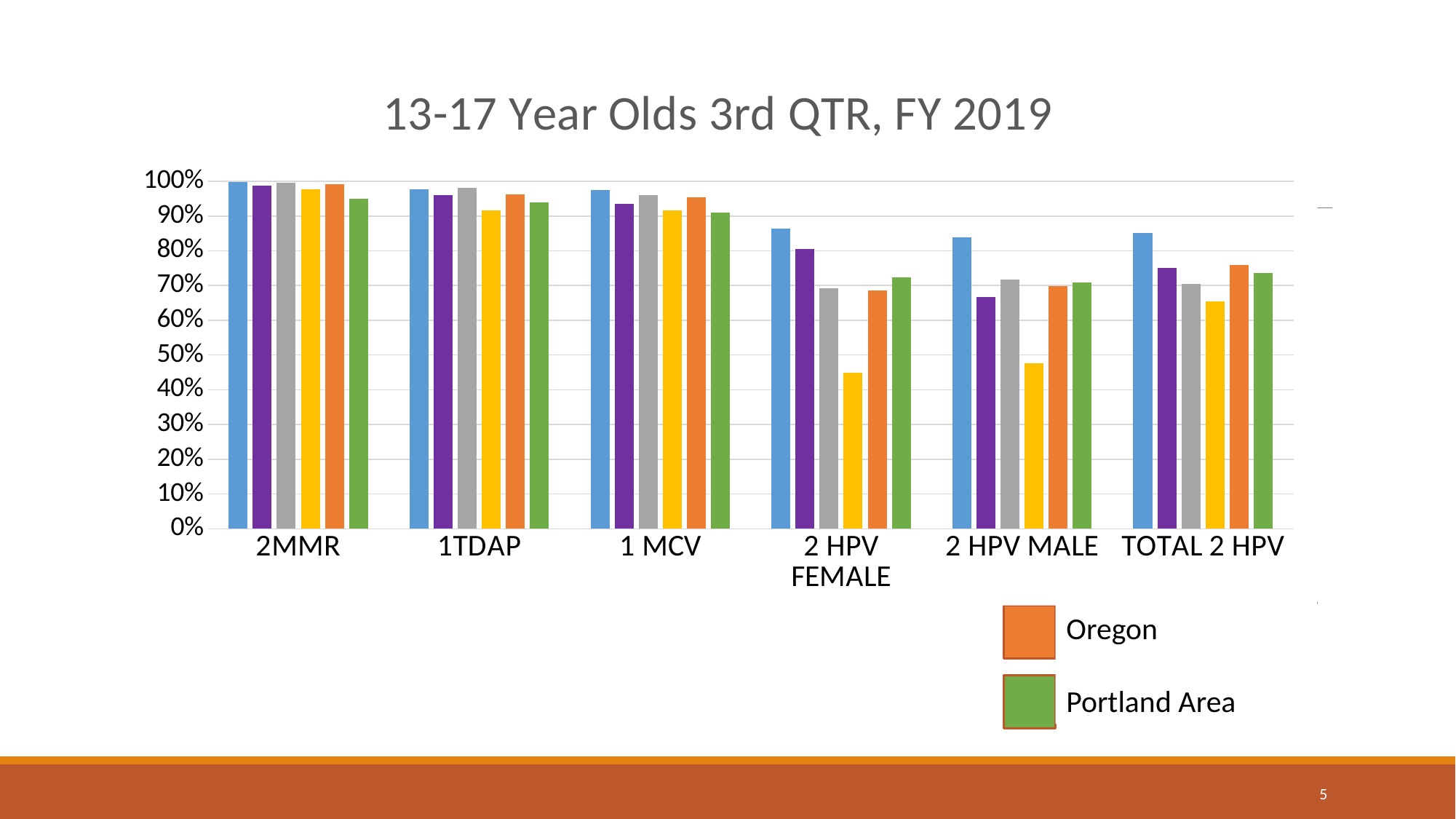
How many categories are shown along the x axis of the chart? 6 Is the Oregon value for 2MMR greater or less than 90%? greater Is the Portland Area value for 1TDAP greater or less than 90%? greater Is the Oregon value for 2 HPV MALE greater or less than 80%? less For 2MMR, which is larger: the Oregon value or the Portland Area value? Oregon How many series does the chart's legend list? 2 What kind of chart is shown on the slide? bar chart Which series is shown in green in the legend? Portland Area What is the title of the chart? 13-17 Year Olds 3rd QTR, FY 2019 For 1 MCV, which is larger: the Oregon value or the Portland Area value? Oregon